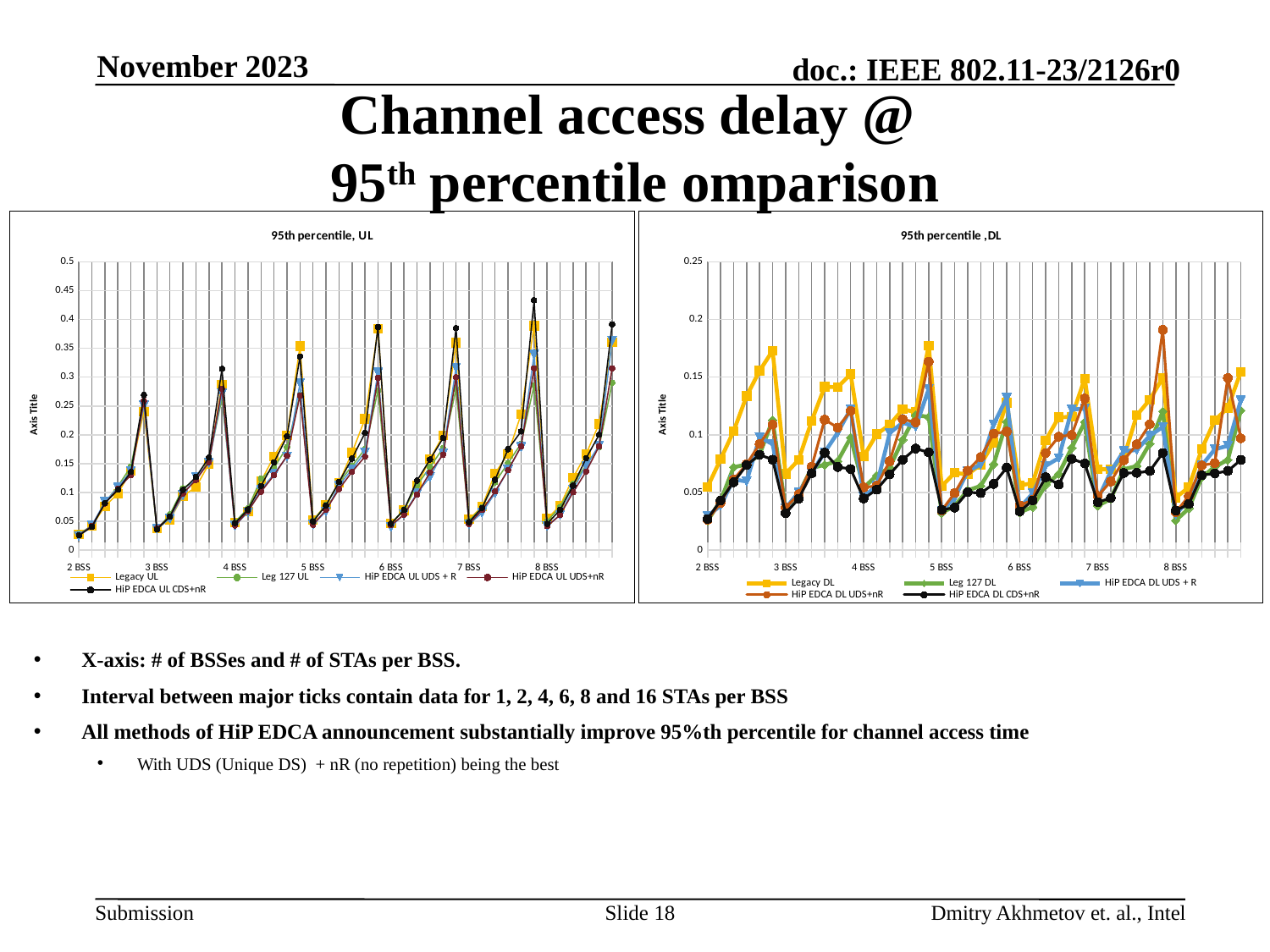
How many series does the legend of the '95th percentile, UL' chart list? 5 What is the maximum value shown on the y-axis of the '95th percentile ,DL' chart? 0.25 In the '95th percentile, UL' chart, is the highest peak of the HiP EDCA UL CDS+nR series greater or less than 0.4? greater How many BSS categories are labelled on the x-axis of the '95th percentile, UL' chart? 7 What type of chart is the '95th percentile, UL' chart? line chart How many series does the legend of the '95th percentile ,DL' chart list? 5 What is the first series listed in the legend of the '95th percentile ,DL' chart? Legacy DL In the '95th percentile, UL' chart, is the highest value of the Legacy UL series greater or less than 0.3? greater How many BSS categories are labelled on the x-axis of the '95th percentile ,DL' chart? 7 In the '95th percentile ,DL' chart, is the highest value of the HiP EDCA DL CDS+nR series greater or less than 0.1? less What type of chart is the '95th percentile ,DL' chart? line chart